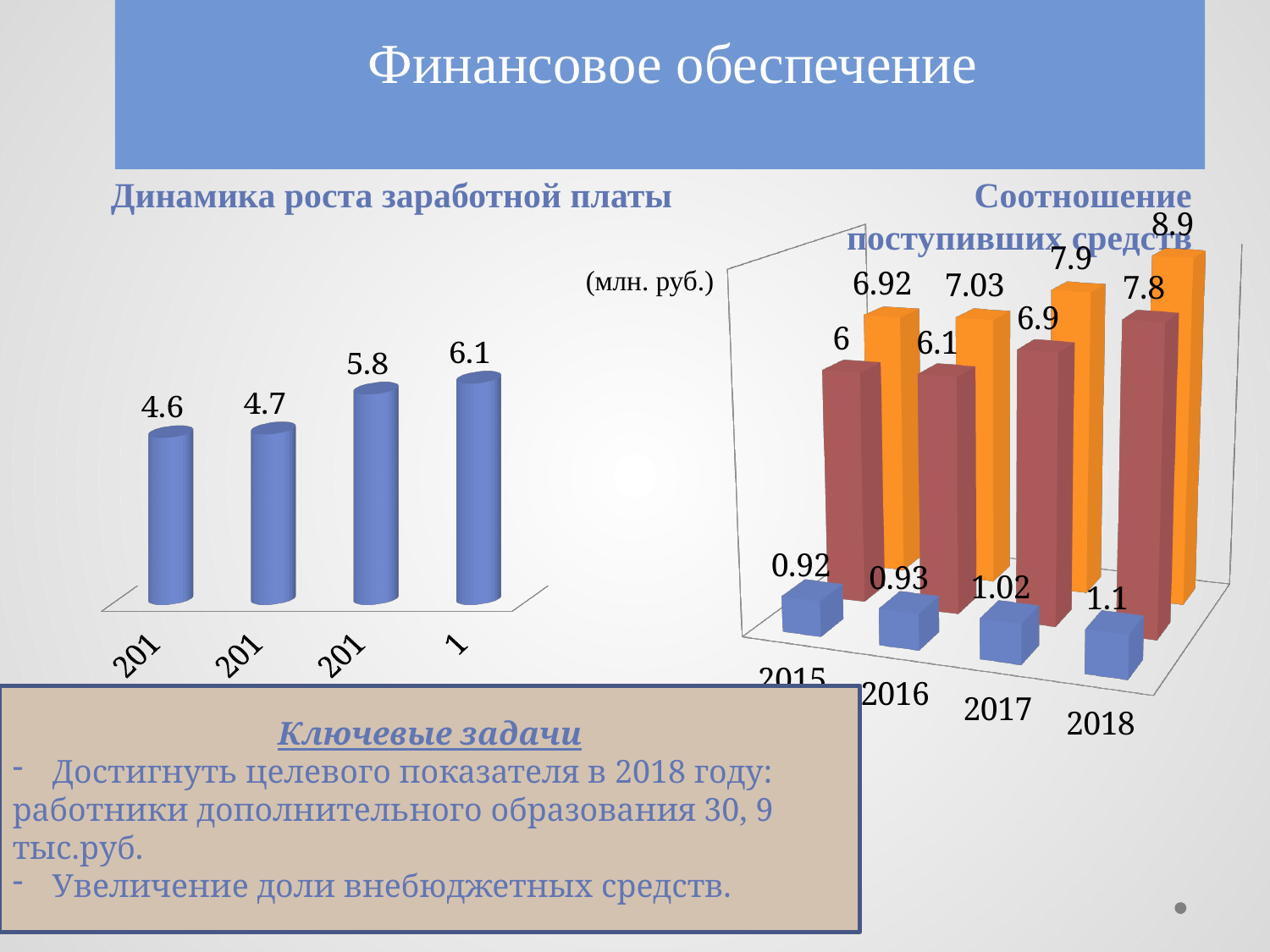
In the chart 'Соотношение поступивших средств', what is the value of the blue bar for 2015? 0.92 In the chart 'Динамика роста заработной платы', what is the value of the tallest bar? 6.1 What type of chart is 'Соотношение поступивших средств'? bar chart In the chart 'Соотношение поступивших средств', which year has the highest orange bar? 2018 In the chart 'Соотношение поступивших средств', what is the value of the orange bar for 2018? 8.9 In the chart 'Динамика роста заработной платы', what is the difference between the last bar and the first bar? 1.5 In the chart 'Динамика роста заработной платы', what is the value of the third bar from the left? 5.8 In the chart 'Динамика роста заработной платы', how many bars are plotted? 4 In the chart 'Динамика роста заработной платы', do the values rise or fall from left to right? rise In the chart 'Соотношение поступивших средств', which is larger: the red bar for 2018 or the orange bar for 2015? the red bar for 2018 In the chart 'Динамика роста заработной платы', what is the value of the shortest bar? 4.6 In the chart 'Соотношение поступивших средств', what is the value of the red bar for 2017? 6.9